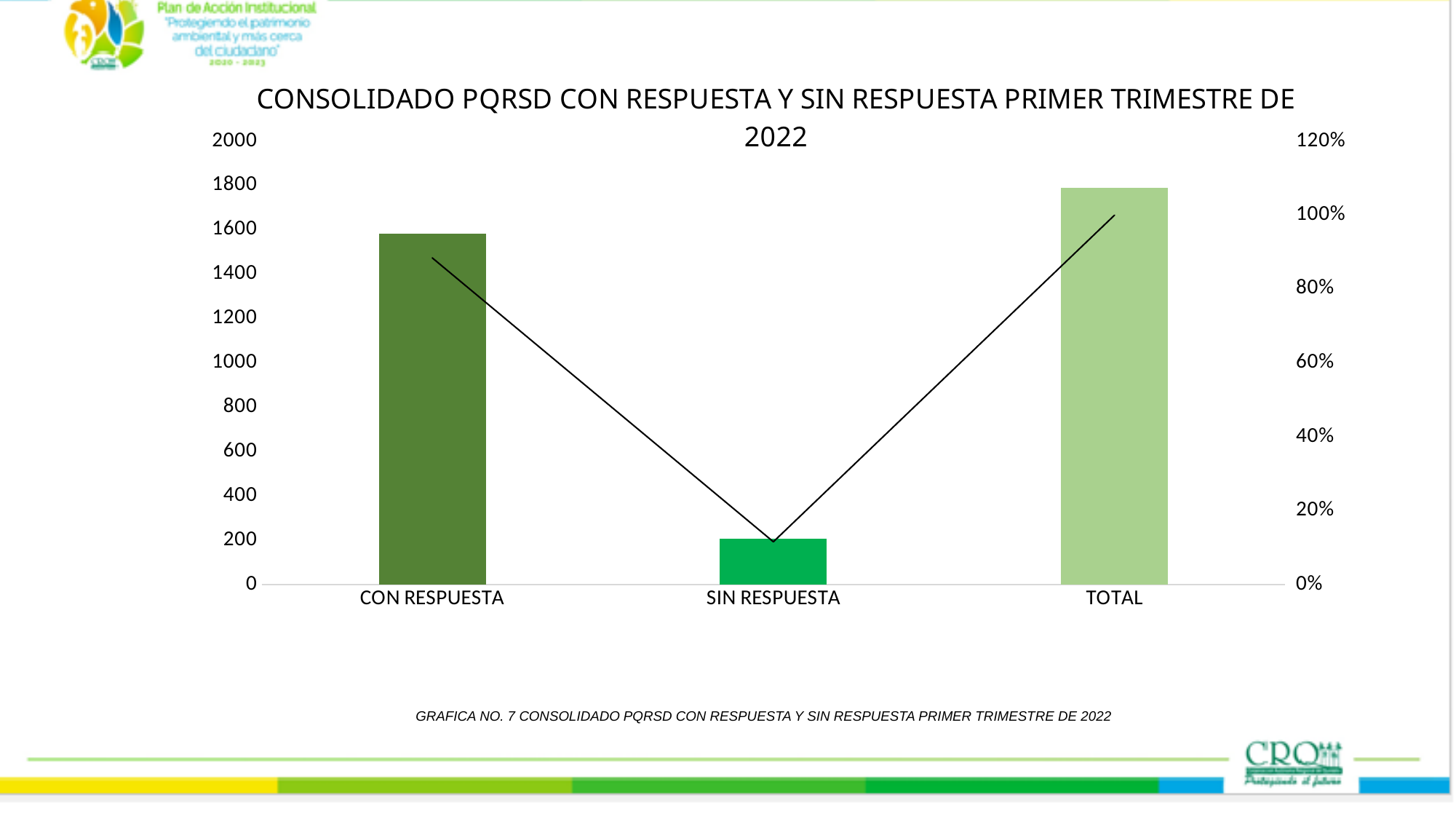
How many categories are shown on the x axis of the chart? 3 On the right-hand percentage axis, is the line value for SIN RESPUESTA greater or less than 20%? less Is the bar value for SIN RESPUESTA greater or less than 400? less What is the title of the chart? CONSOLIDADO PQRSD CON RESPUESTA Y SIN RESPUESTA PRIMER TRIMESTRE DE 2022 What is the highest tick value shown on the right-hand percentage axis? 120% On the right-hand percentage axis, is the line value for CON RESPUESTA greater or less than 80%? greater Which category has the tallest bar? TOTAL Which category has the shortest bar? SIN RESPUESTA What kind of chart is shown on the slide? combination bar and line chart Which bar is taller, CON RESPUESTA or SIN RESPUESTA? CON RESPUESTA